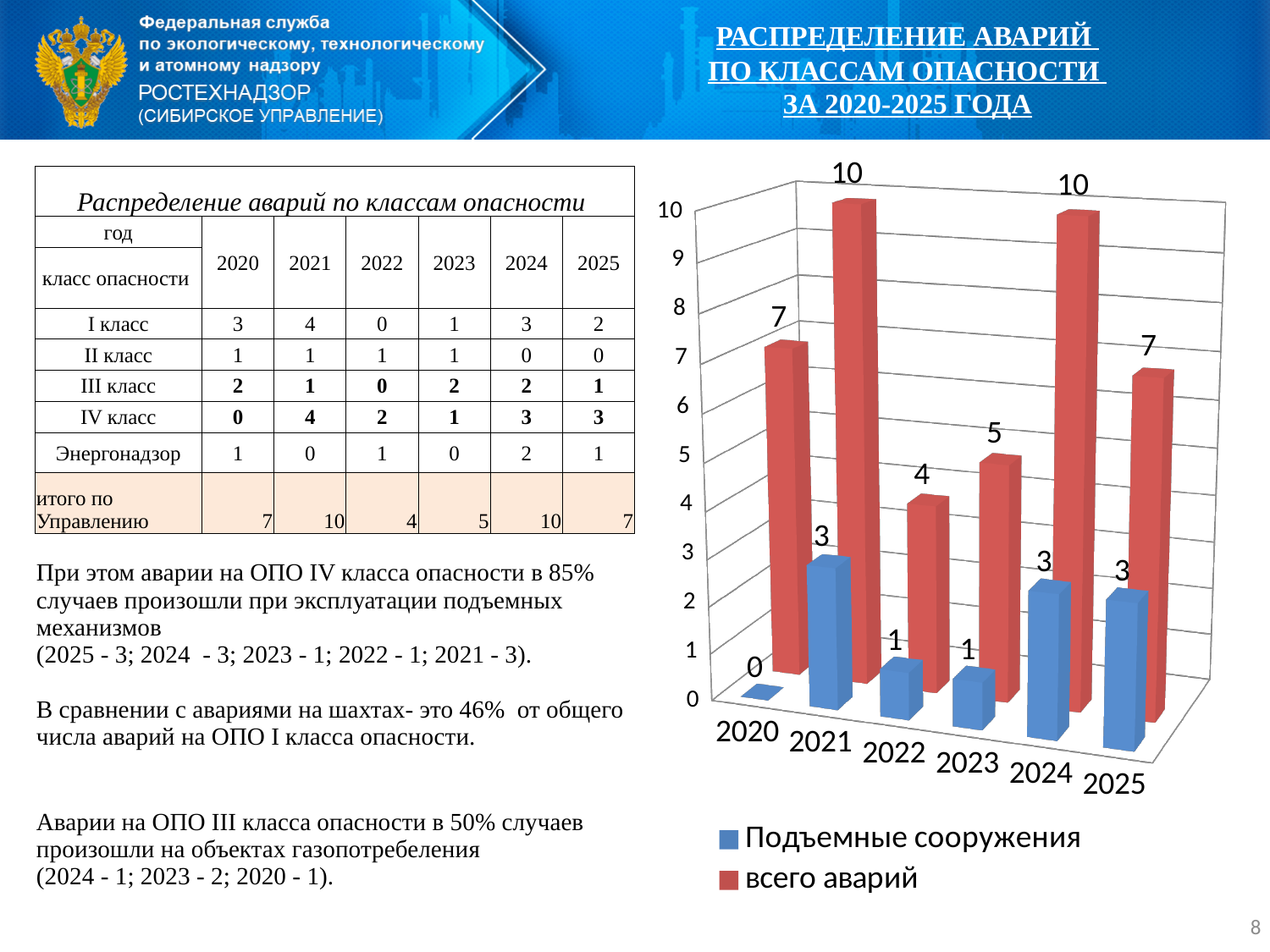
Which year has the lowest value for "всего аварий"? 2022 What type of chart is shown on the slide? bar chart Does the value of "всего аварий" rise or fall from 2021 to 2022? fall Which is larger: "всего аварий" in 2020 or "всего аварий" in 2022? 2020 Which series in the chart is shown in red? всего аварий What is the value of "всего аварий" for 2023? 5 How many years are shown on the x axis of the chart? 6 Which year has the lowest value for "Подъемные сооружения"? 2020 What is the value of "Подъемные сооружения" for 2020? 0 What is the value of "всего аварий" for 2021? 10 What is the difference between "всего аварий" and "Подъемные сооружения" in 2024? 7 How many series does the chart legend list? 2